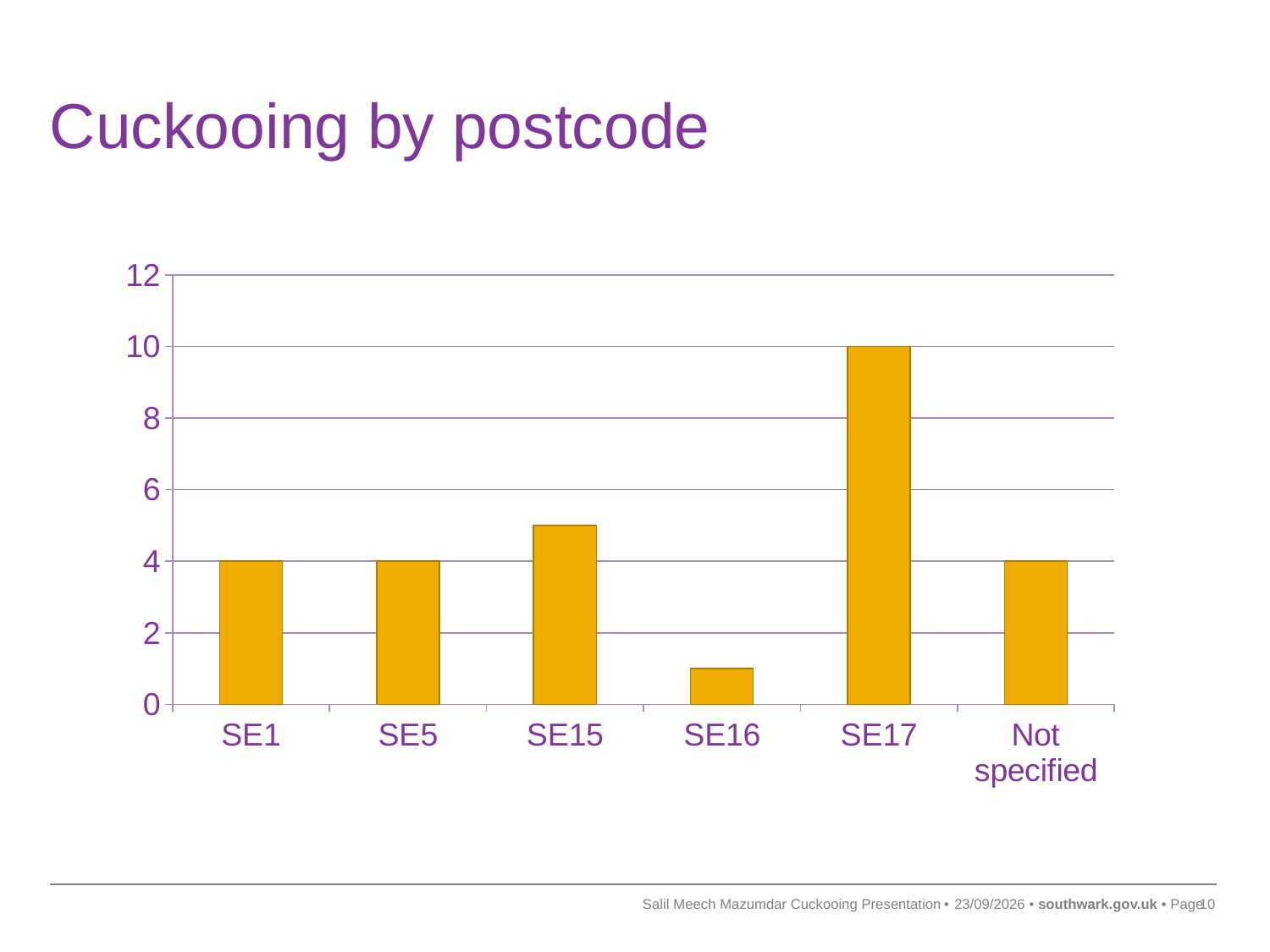
What is the value for Not specified? 4 What kind of chart is shown on the slide? bar chart How many categories are shown on the x axis? 6 What is the value for SE1? 4 Which category has the lowest value? SE16 Which is larger, the value for SE17 or the value for Not specified? SE17 What is the title of the slide? Cuckooing by postcode Is the value for SE16 greater or less than 2? less Which postcode has the highest value? SE17 Is the value for SE15 greater or less than 4? greater What is the difference between the values for SE17 and SE5? 6 What is the value for SE17? 10